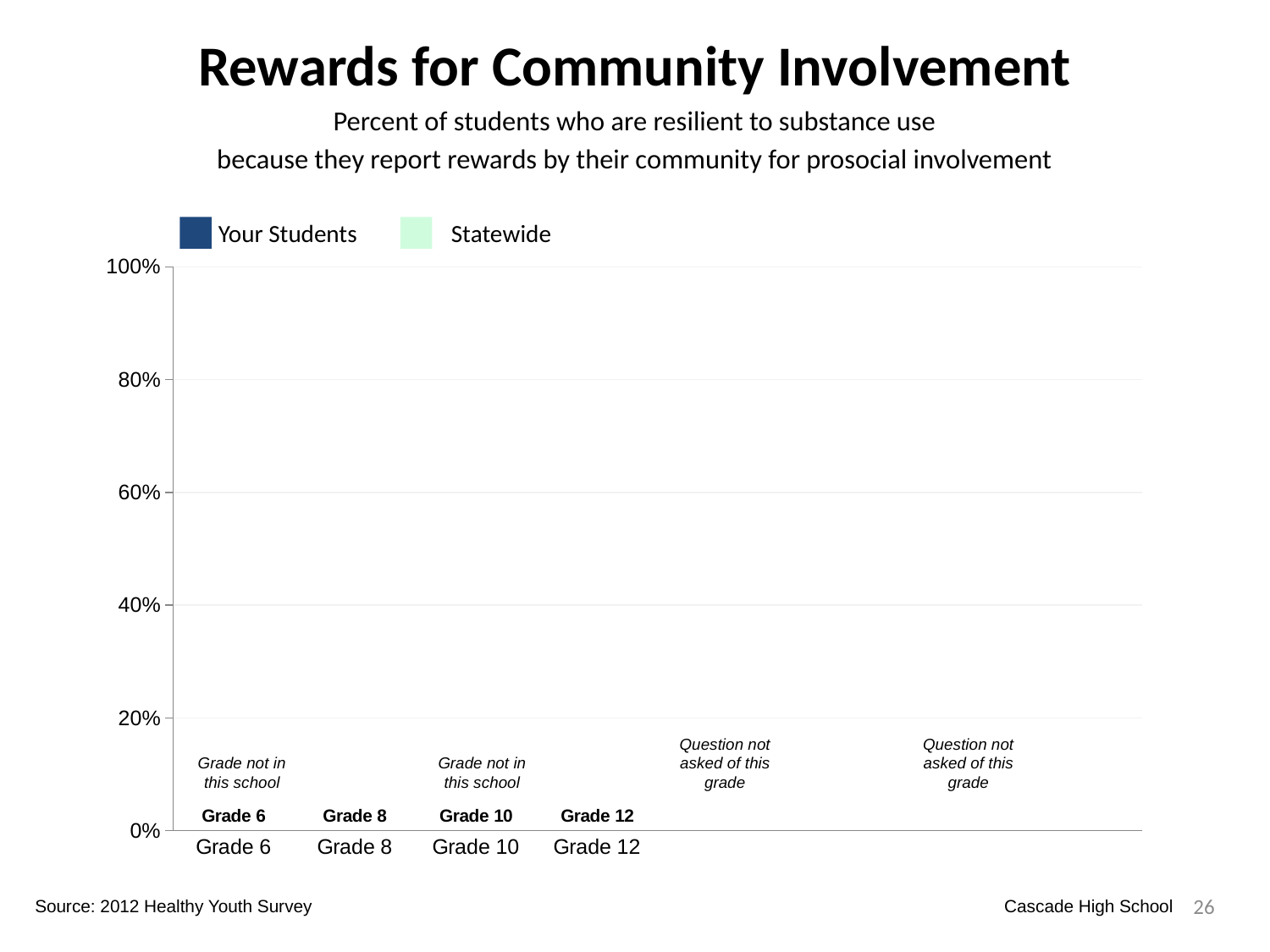
What are the two series named in the legend? Your Students and Statewide What note is shown for Grade 10 on the chart? Grade not in this school What is the highest value shown on the y axis? 100% What is the source cited for the chart data? 2012 Healthy Youth Survey What note is shown for Grade 6 on the chart? Grade not in this school Which school is the chart about? Cascade High School How many grade categories are shown on the x axis? 4 What is the title of the chart? Rewards for Community Involvement How many series does the legend list? 2